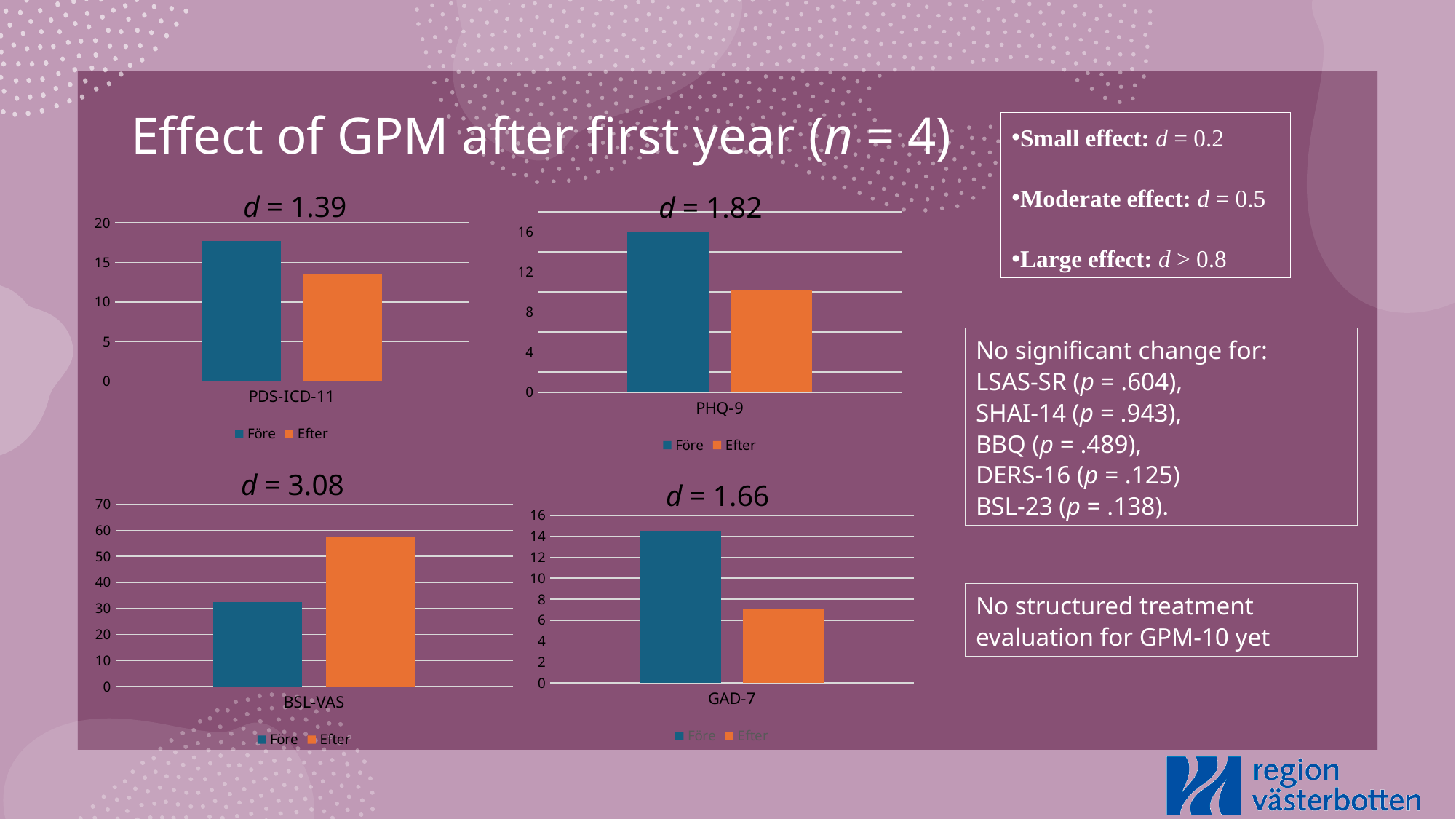
In the GAD-7 chart, is the value for Före greater or less than 12? greater In the PDS-ICD-11 chart, is the value for Efter greater or less than 10? greater In the GAD-7 chart, is the value for Efter greater or less than 8? less What kind of chart is the PDS-ICD-11 chart? bar chart What effect size (d) is shown as the title of the BSL-VAS chart? d = 3.08 In the BSL-VAS chart, which is larger, Före or Efter? Efter How many series does the legend of the PHQ-9 chart list? 2 Which colour represents the Efter series in the PHQ-9 chart? orange In the PDS-ICD-11 chart, which is larger, Före or Efter? Före